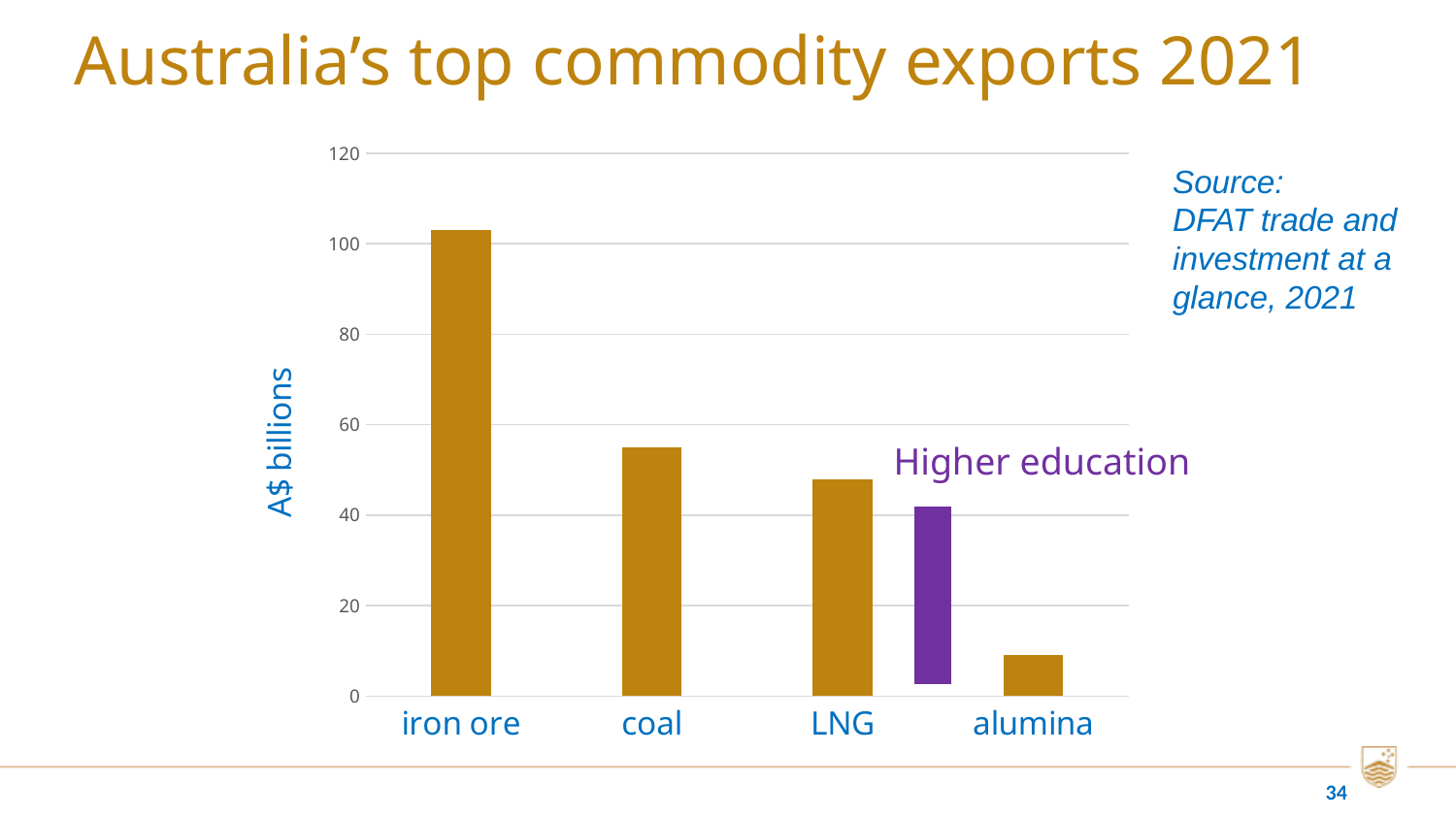
Which is larger, the value for Higher education or the value for alumina? Higher education Is the value for iron ore greater or less than 80? greater Is the value for Higher education greater or less than 60? less Which is larger, the value for coal or the value for LNG? coal Is the value for alumina greater or less than 20? less Which commodity has the highest export value in the chart? iron ore What kind of chart is shown on the slide? bar chart How many commodity categories are labelled on the x axis? 4 Which commodity has the lowest export value in the chart? alumina Do the commodity export values rise or fall from left to right along the x axis? fall